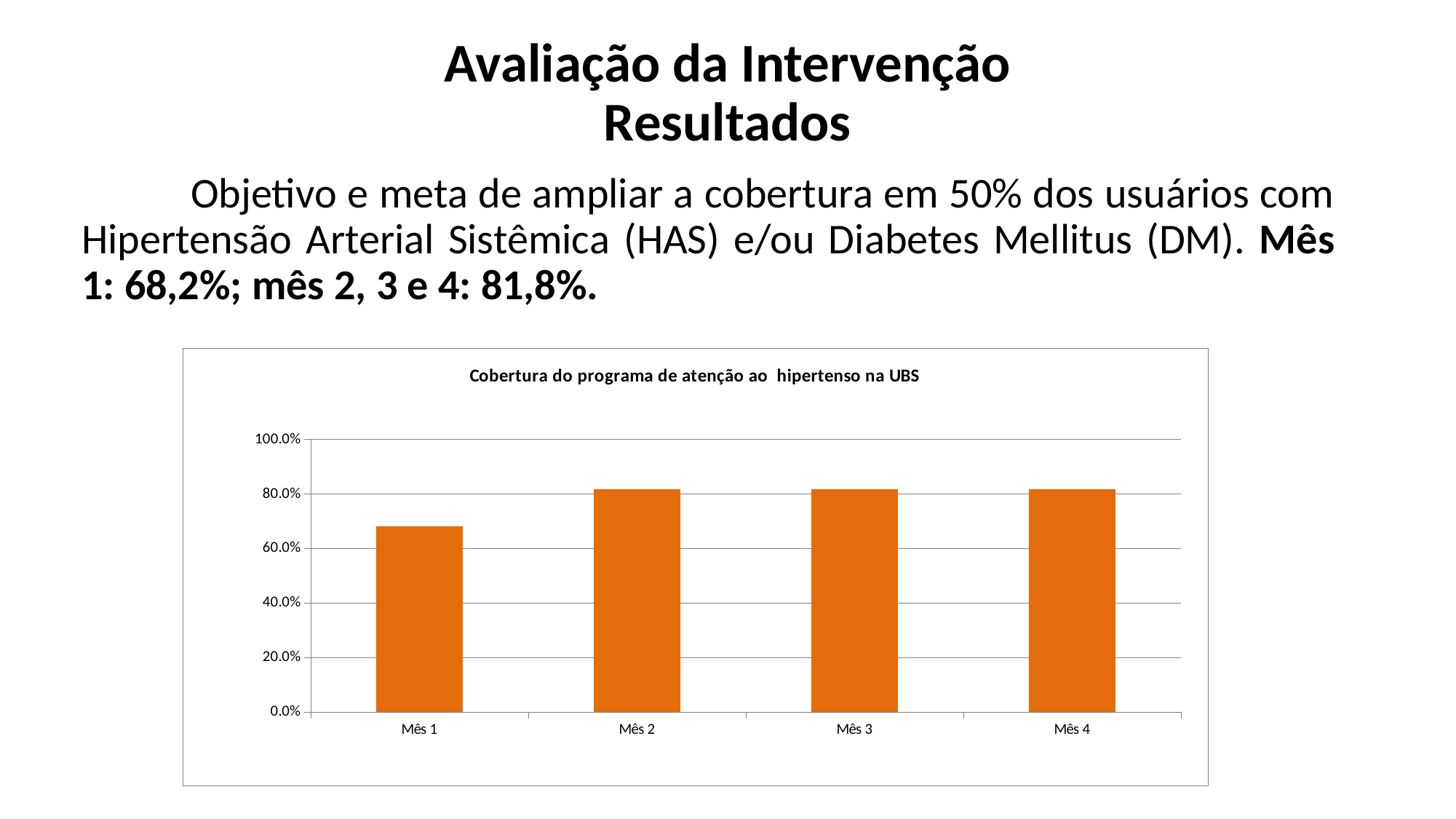
Which is larger, the coverage for Mês 1 or for Mês 2? Mês 2 According to the slide text, what was the coverage in Mês 1? 68,2% Is the value for Mês 4 greater or less than 100%? less What type of chart is shown on the slide? bar chart How many months (categories) are plotted on the x axis of the chart? 4 Is the value for Mês 1 greater or less than 60%? greater According to the slide text, what was the coverage in Mês 2, 3 and 4? 81,8% What is the title of the chart? Cobertura do programa de atenção ao hipertenso na UBS Is the value for Mês 3 greater or less than 80%? greater How does the coverage change from Mês 1 to Mês 4 in the chart? It rises from Mês 1 to Mês 2, then stays level through Mês 4 Which month has the lowest coverage in the chart? Mês 1